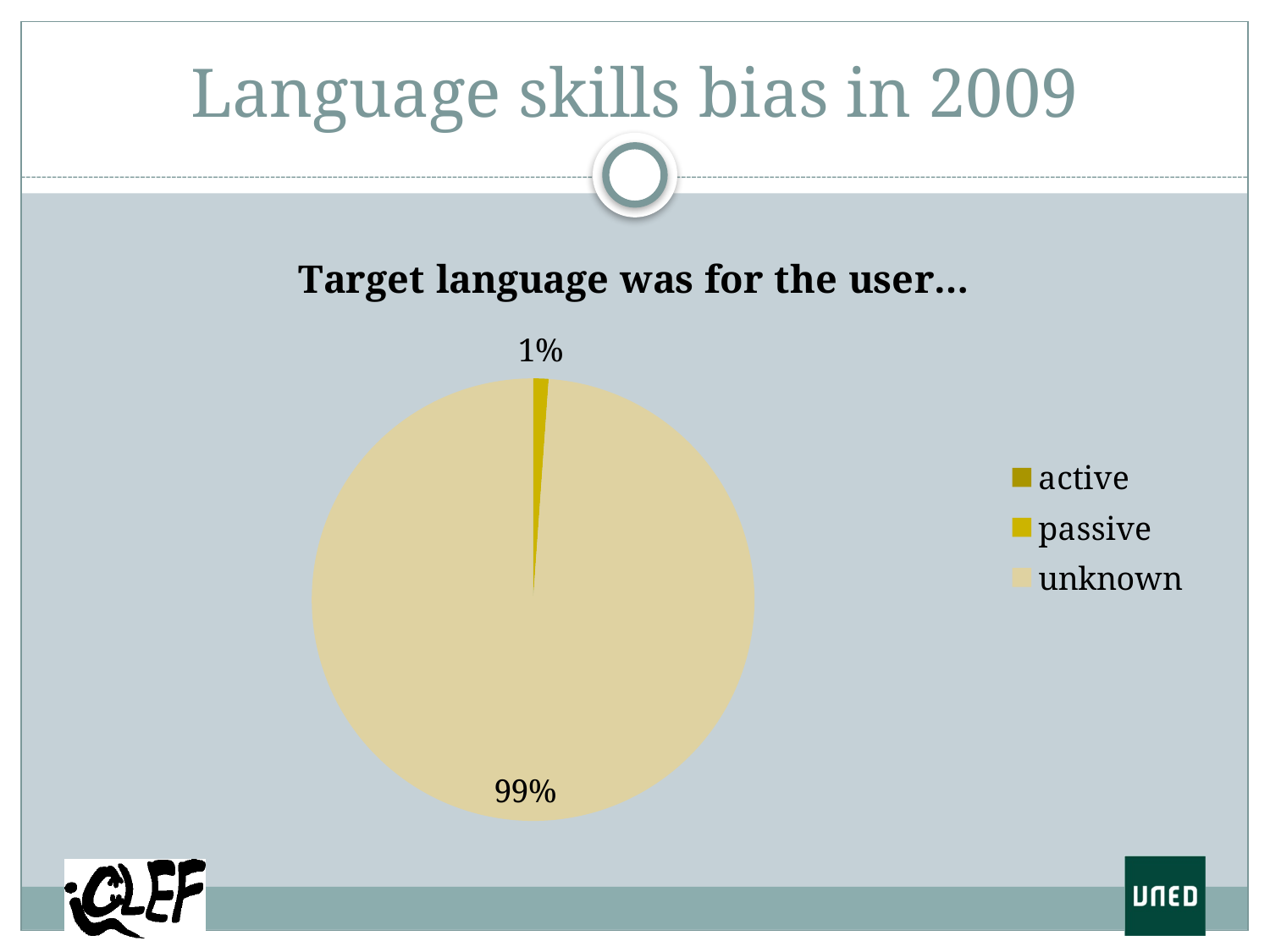
How many entries does the legend of the pie chart list? 3 What share of the pie does the 'unknown' slice represent? 99% What is the title of the pie chart? Target language was for the user... What percentage is shown for the 'passive' slice? 1% What kind of chart is shown on the slide? pie chart Which category has the largest slice of the pie? unknown Which is larger, the 'passive' slice or the 'unknown' slice? unknown Which legend entries are listed for the pie chart? active, passive, unknown What is the difference in percentage points between the 'unknown' slice and the 'passive' slice? 98